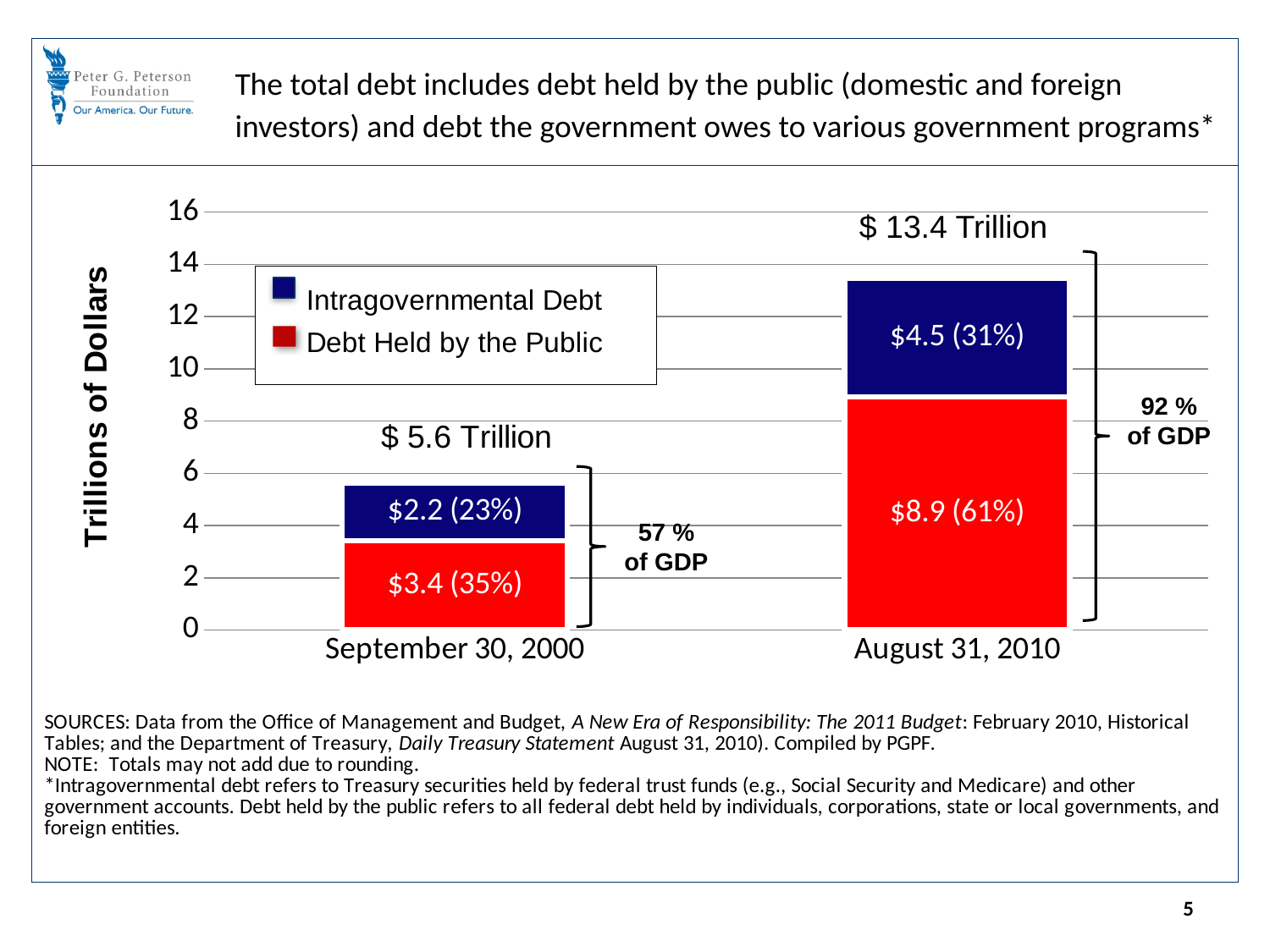
What is the data label for Debt Held by the Public on September 30, 2000? $3.4 (35%) How many series does the legend list? 2 Which date has the larger Intragovernmental Debt? August 31, 2010 Which colour represents Debt Held by the Public in the legend? Red What percentage of GDP is the total debt on August 31, 2010? 92 % What is the data label for Intragovernmental Debt on August 31, 2010? $4.5 (31%) What kind of chart is shown on the slide? Stacked bar chart How many categories (dates) are shown on the x axis? 2 By how many trillions of dollars did Debt Held by the Public increase from September 30, 2000 to August 31, 2010? 5.5 What is the total debt shown for August 31, 2010? $ 13.4 Trillion Is the total debt for September 30, 2000 greater or less than 6 trillion dollars? less What is the total debt shown for September 30, 2000? $ 5.6 Trillion